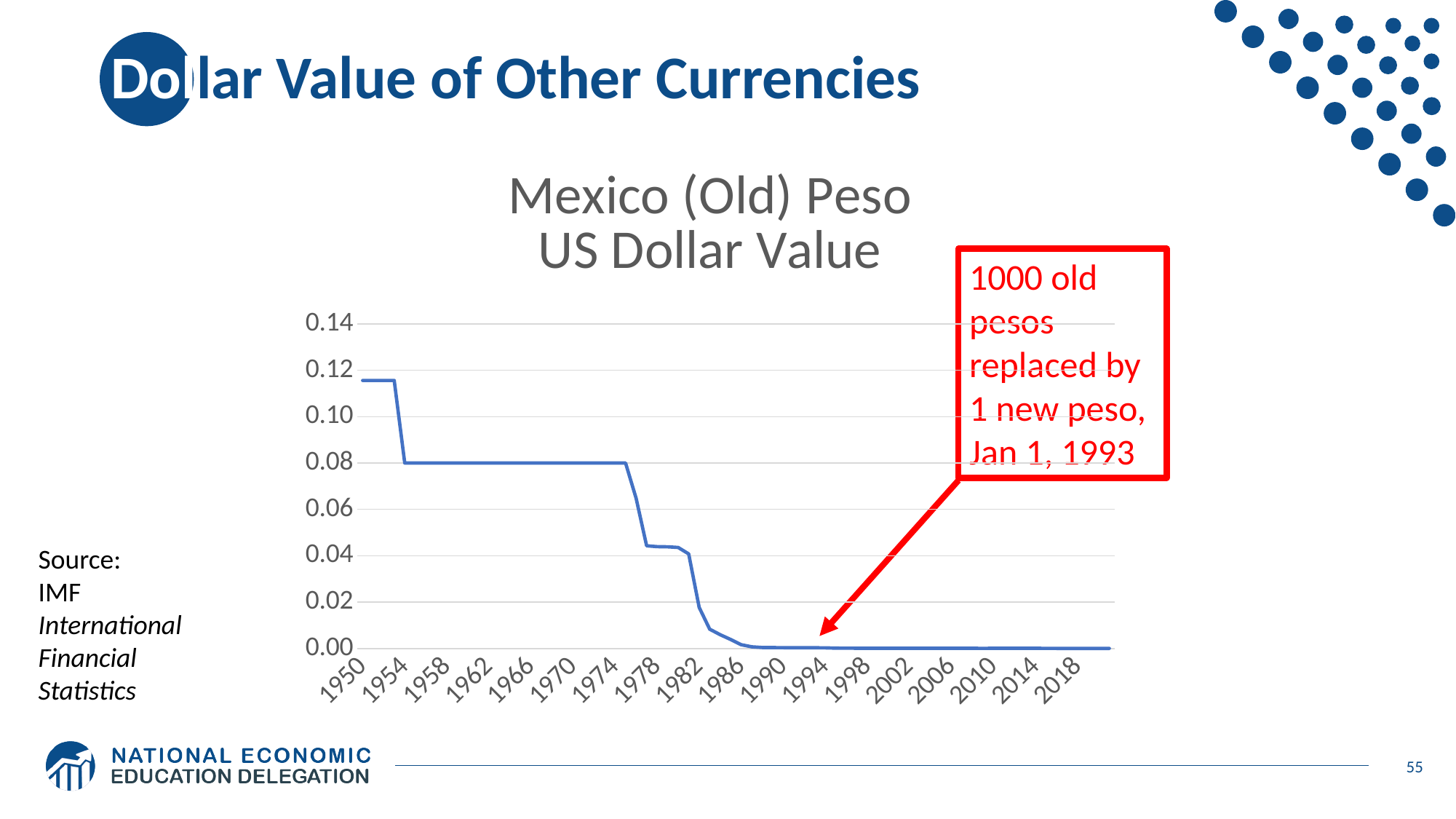
Which year has the higher value, 1978 or 1990? 1978 Is the value for 1950 greater or less than 0.10? greater What is the title of the chart? Mexico (Old) Peso US Dollar Value Is the value for 1966 greater or less than 0.06? greater Is the value for 1958 greater or less than 0.10? less How many year labels are shown on the x axis? 18 What is the highest value shown on the y axis? 0.14 Does the value of the Mexican old peso rise or fall over the period shown on the x axis? fall What kind of chart is shown on the slide? line chart Which year has the higher value, 1950 or 1970? 1950